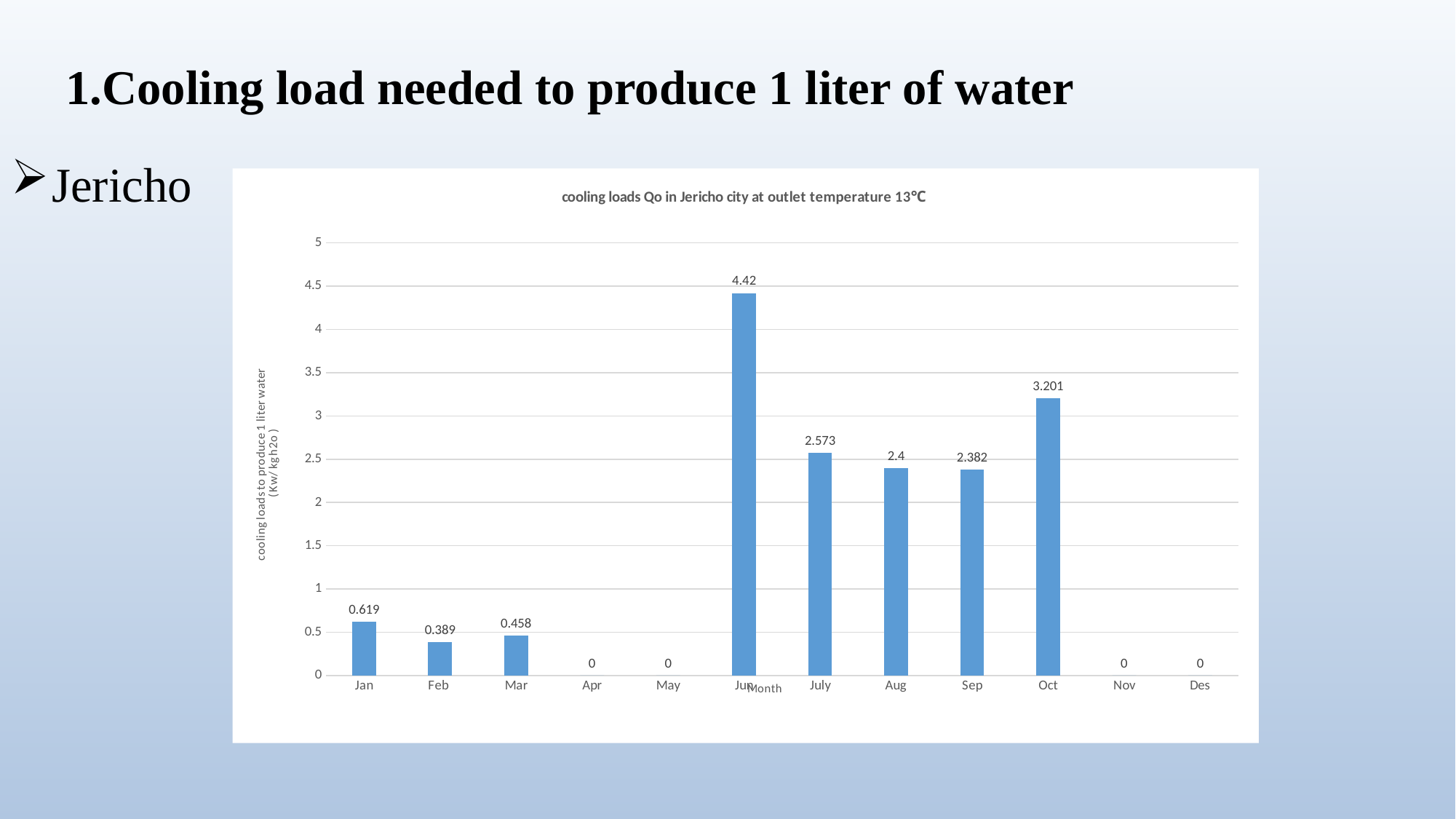
Is the value for Jun greater or less than 4? greater What is the difference between the cooling load values for Jun and Oct? 1.219 How many months are shown on the x axis? 12 What is the title of the chart? cooling loads Qo in Jericho city at outlet temperature 13℃ Which month has the highest cooling load? Jun What is the cooling load value for Sep? 2.382 What is the cooling load value for Oct? 3.201 What is the cooling load value for Jun? 4.42 What is the difference between the cooling load values for July and Aug? 0.173 What kind of chart is shown on the slide? Bar chart Which has a larger cooling load, Jan or Mar? Jan What is the cooling load value for Feb? 0.389